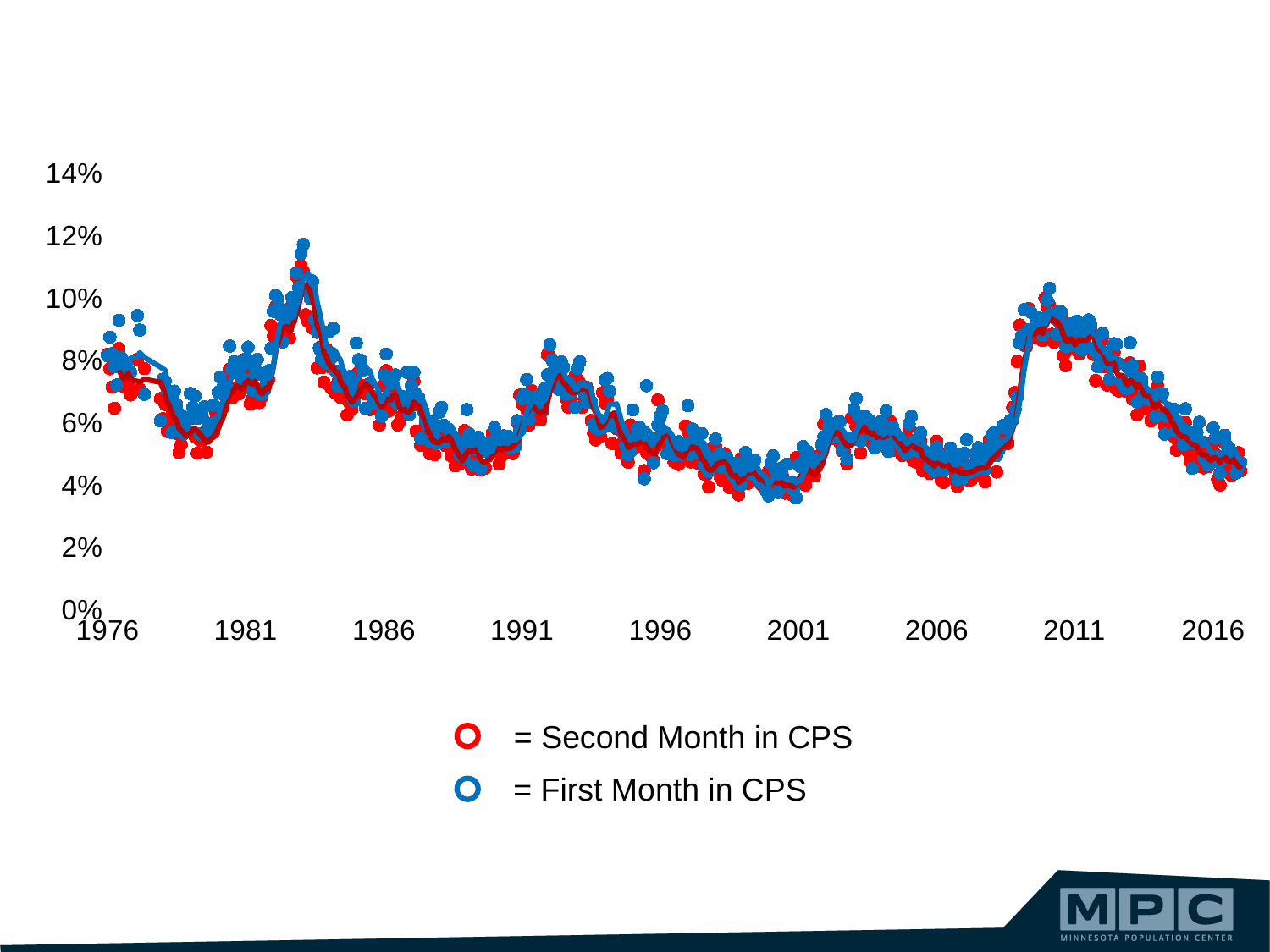
Are the values around 2000 greater or less than 6%? less Do the values rise or fall between 2011 and 2016? fall Is the peak value reached around 1983 greater or less than 10%? greater How many series does the legend list? 2 What is the highest value shown on the vertical axis? 14% Are the values at the end of the series in 2016 greater or less than 6%? less Around which year do the plotted values reach their highest level? 1983 Which series is plotted in blue? First Month in CPS What kind of chart is shown on the slide? scatter chart Do the values rise or fall between 2006 and 2010? rise Which series is plotted in red? Second Month in CPS